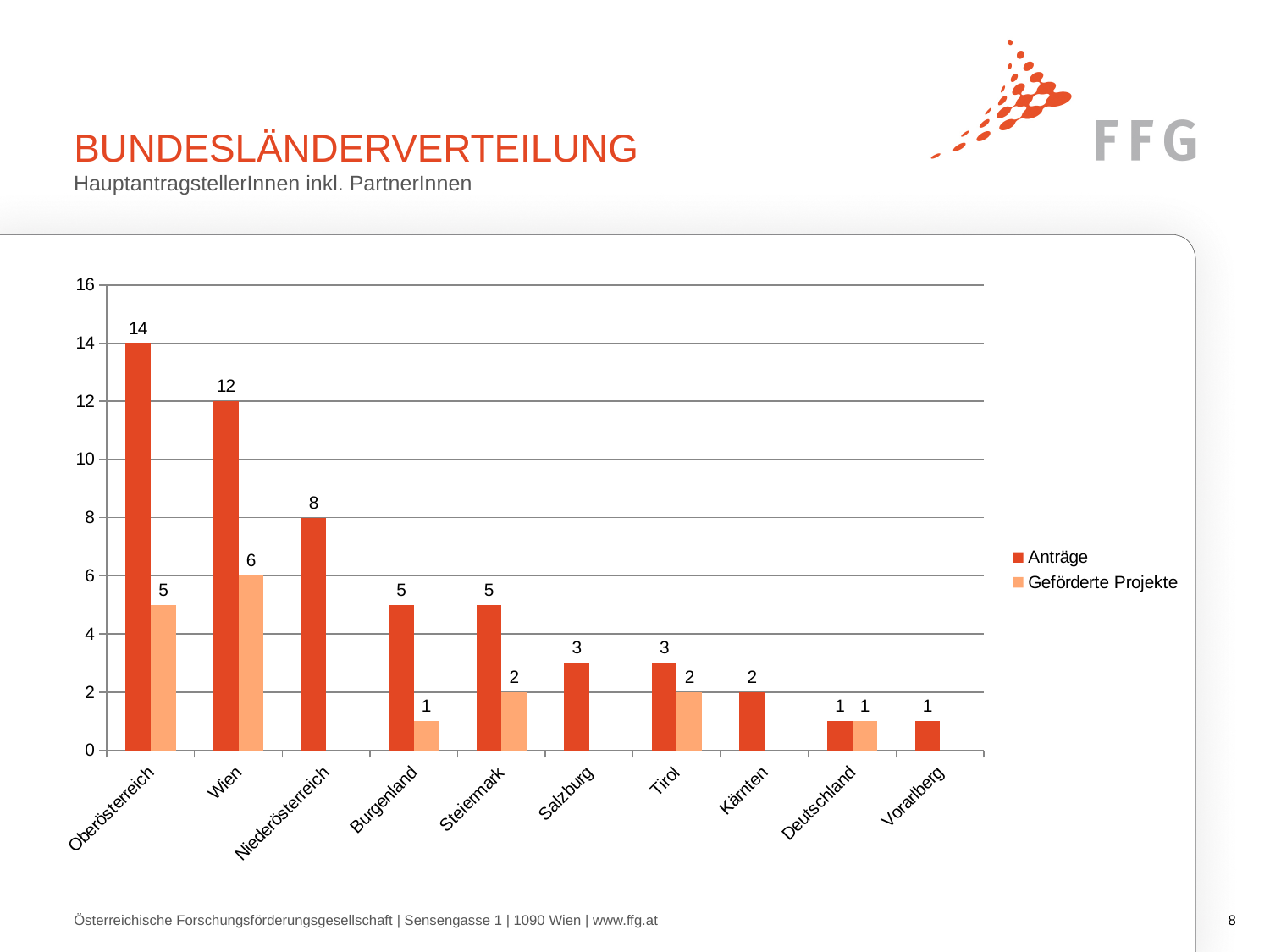
What is the difference between Anträge and Geförderte Projekte for Oberösterreich? 9 Do the Anträge values rise or fall from Oberösterreich to Vorarlberg along the x axis? fall How many categories are shown on the x axis? 10 What is the title of the slide containing the chart? BUNDESLÄNDERVERTEILUNG Which is larger: Anträge for Wien or Anträge for Niederösterreich? Wien What kind of chart is shown on the slide? bar chart Which category has the highest value for Anträge? Oberösterreich What is the value of Anträge for Niederösterreich? 8 Which category has the highest value for Geförderte Projekte? Wien What is the value of Geförderte Projekte for Wien? 6 What is the value of Anträge for Oberösterreich? 14 How many series does the legend list? 2